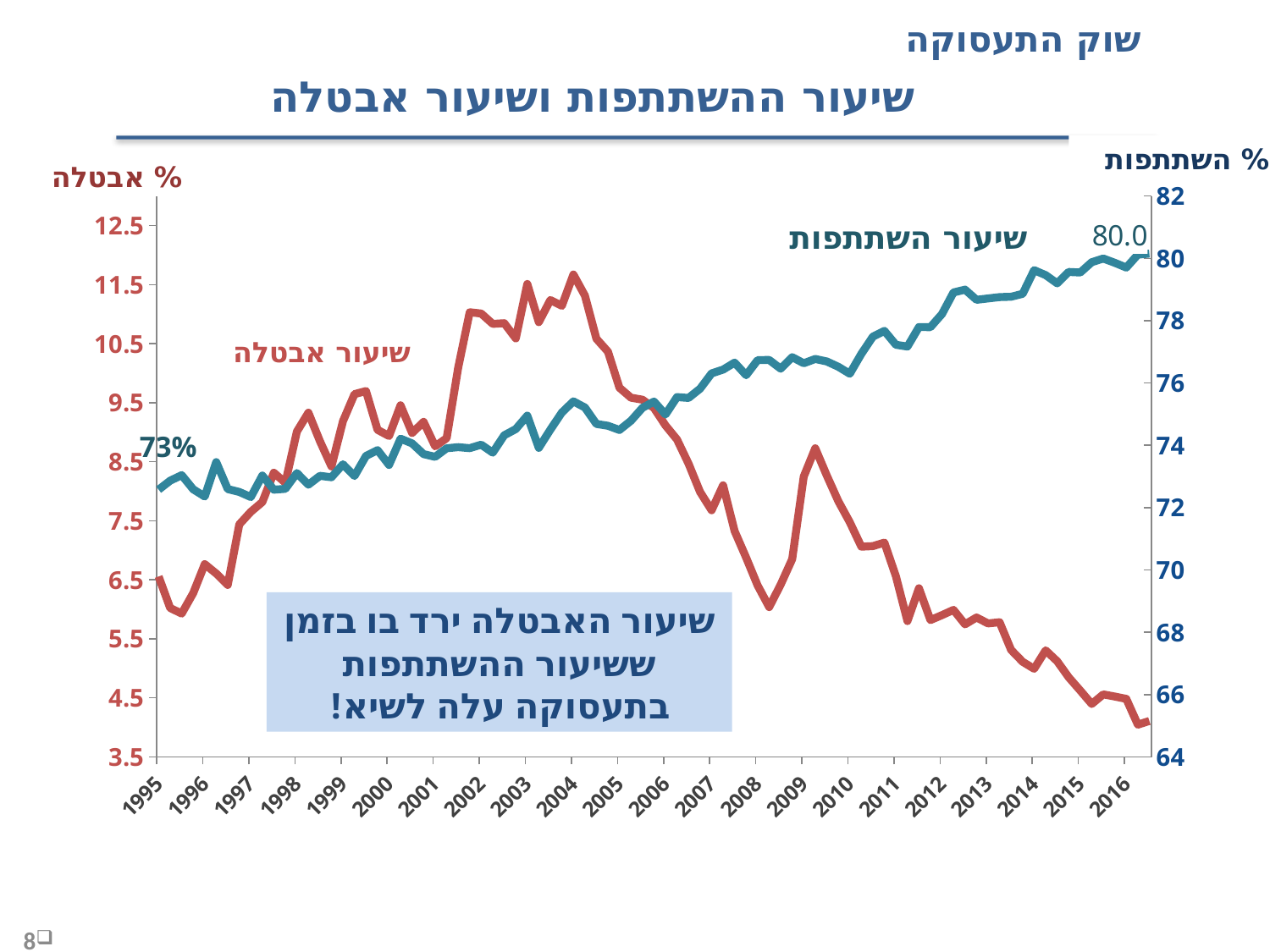
In which year does the unemployment rate (שיעור אבטלה) reach its highest point? 2004 By how much did the labelled participation rate rise between 1995 (73%) and 2016 (80.0)? 7 What kind of chart is shown on the slide? line chart How many year labels are shown on the x axis? 22 Which is larger, the participation rate in 1995 or in 2016? 2016 What is the labelled value of the participation rate (שיעור השתתפות) at the start of the series in 1995? 73% Does the participation rate (שיעור השתתפות) generally rise or fall from 1995 to 2016? rise Does the unemployment rate (שיעור אבטלה) rise or fall from 2004 to 2016? fall Is the participation rate in 2012 greater or less than 76? greater Is the unemployment rate at its 2004 peak greater or less than 10.5? greater Is the unemployment rate in 2016 greater or less than 5.5? less What is the labelled value of the participation rate (שיעור השתתפות) at the end of the series in 2016? 80.0